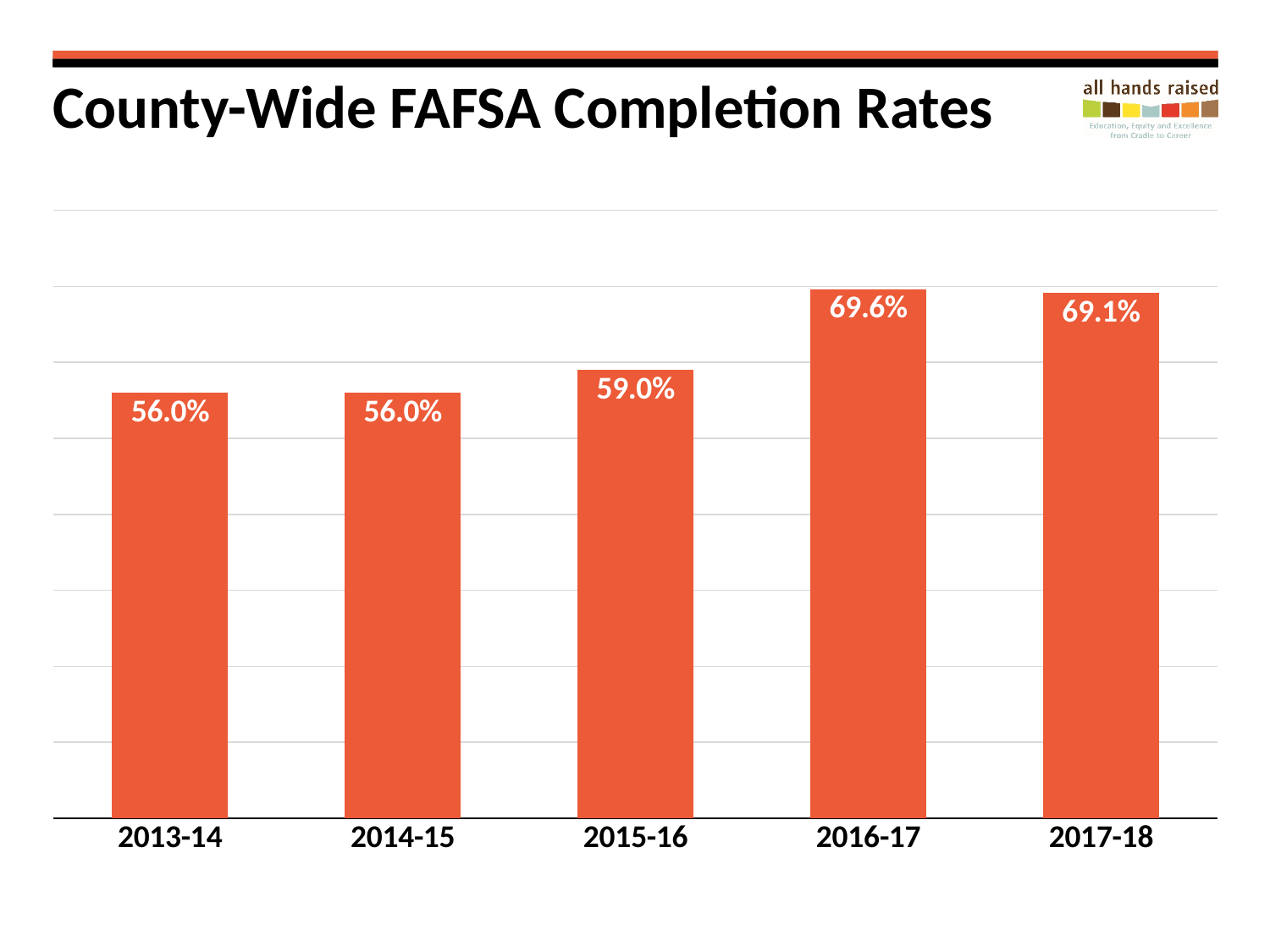
What is the FAFSA completion rate for 2017-18? 69.1% Which year has the highest FAFSA completion rate? 2016-17 What is the difference between the 2016-17 and 2015-16 completion rates? 10.6% What is the difference between the 2017-18 and 2013-14 completion rates? 13.1% What is the FAFSA completion rate for 2016-17? 69.6% What is the title of the chart? County-Wide FAFSA Completion Rates What kind of chart is shown on the slide? Bar chart Do the completion rates generally rise or fall from 2013-14 to 2016-17? Rise How many school years are shown on the chart? 5 What is the FAFSA completion rate for 2013-14? 56.0% What is the FAFSA completion rate for 2015-16? 59.0% Which is larger, the completion rate for 2015-16 or for 2014-15? 2015-16